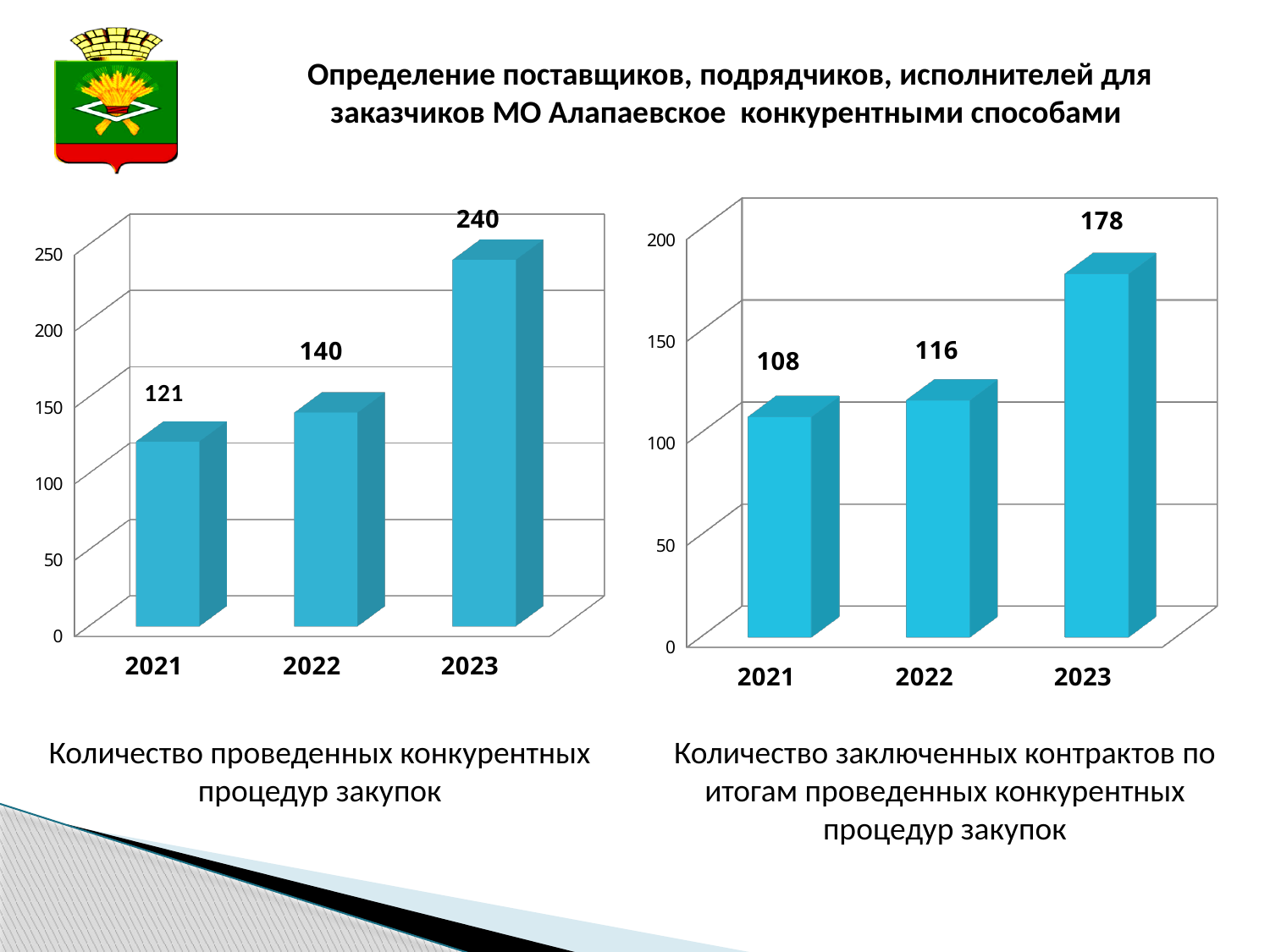
In the right chart (Количество заключенных контрактов по итогам проведенных конкурентных процедур закупок), what is the value for 2022? 116 In the left chart (Количество проведенных конкурентных процедур закупок), do the values rise or fall from 2021 to 2023? rise In the left chart (Количество проведенных конкурентных процедур закупок), what is the value for 2021? 121 In the right chart (Количество заключенных контрактов), what is the difference between the values for 2023 and 2021? 70 In the left chart (Количество проведенных конкурентных процедур закупок), what is the value for 2023? 240 What kind of chart is the left chart (Количество проведенных конкурентных процедур закупок)? bar chart In the left chart (Количество проведенных конкурентных процедур закупок), is the value for 2022 greater or less than 150? less How many years are shown on the x axis of the right chart (Количество заключенных контрактов)? 3 In the right chart (Количество заключенных контрактов), which is larger: the value for 2021 or the value for 2022? 2022 In the left chart (Количество проведенных конкурентных процедур закупок), what is the difference between the values for 2023 and 2022? 100 In the left chart (Количество проведенных конкурентных процедур закупок), which year has the lowest value? 2021 In the right chart (Количество заключенных контрактов), which year has the highest value? 2023